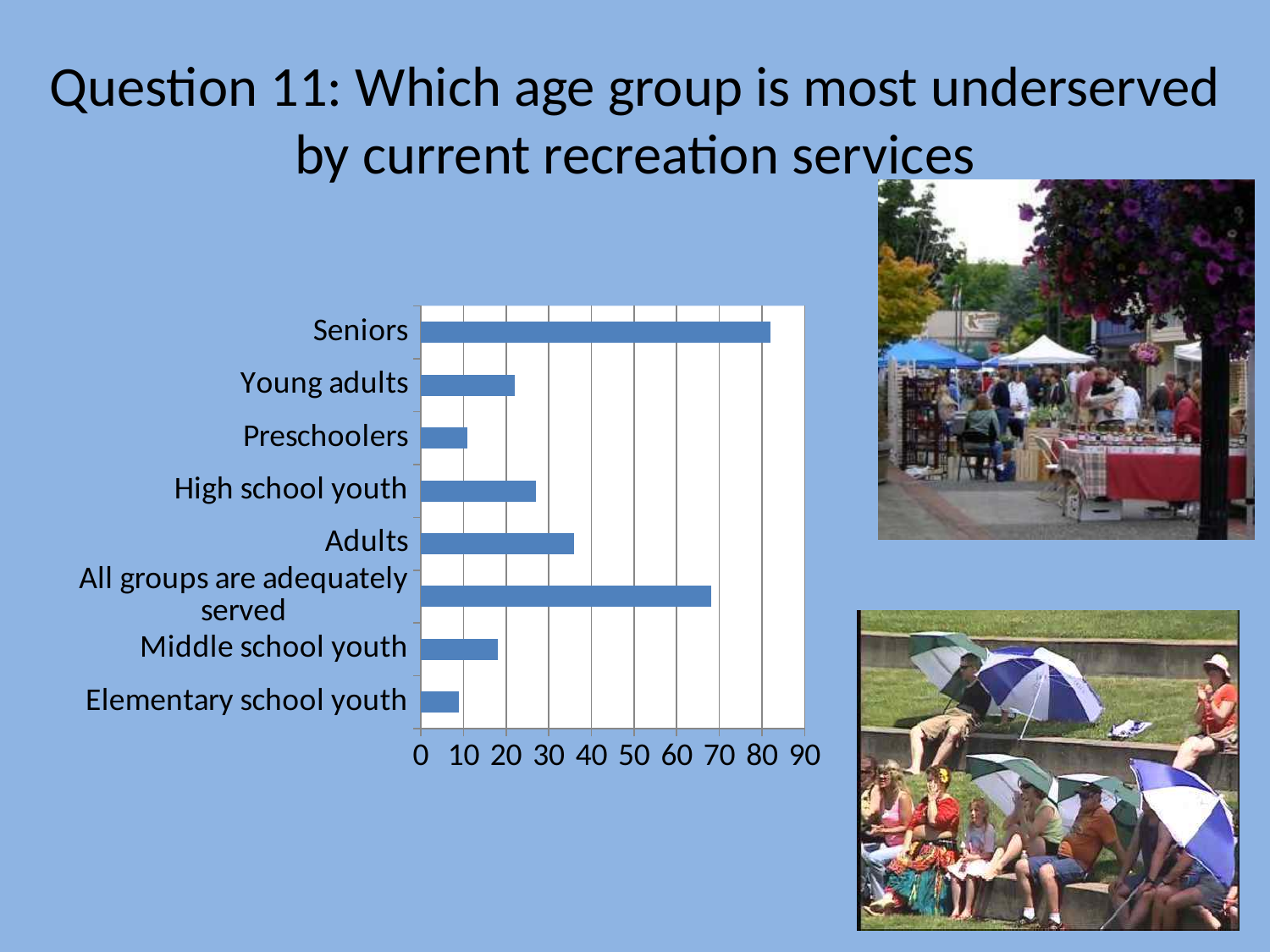
What kind of chart is shown on the slide? bar chart Which is larger, the value for High school youth or the value for Middle school youth? High school youth Is the value for Adults greater or less than 30? greater Is the value for Seniors greater or less than 80? greater How many categories are plotted in the chart? 8 What is the highest value shown on the horizontal axis of the chart? 90 Which category has the lowest value in the chart? Elementary school youth Is the value for Young adults greater or less than 30? less Which is larger, the value for Adults or the value for Young adults? Adults Which category has the highest value in the chart? Seniors